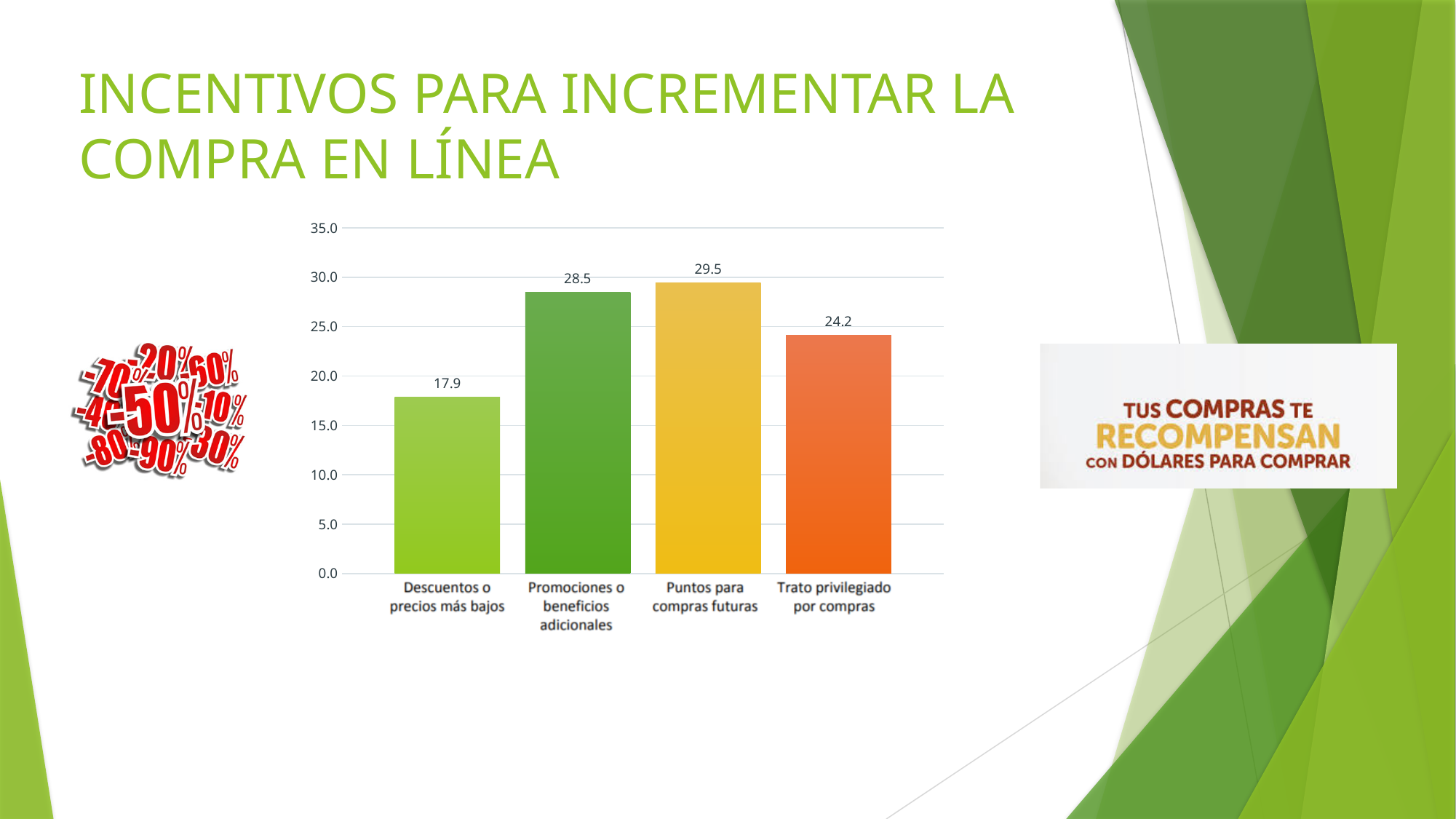
Which category has the lowest value? Descuentos o precios más bajos What is the difference between the values for "Puntos para compras futuras" and "Descuentos o precios más bajos"? 11.6 What is the value for "Trato privilegiado por compras"? 24.2 What is the value for "Descuentos o precios más bajos"? 17.9 What is the value for "Puntos para compras futuras"? 29.5 How many categories are shown in the chart? 4 What is the value for "Promociones o beneficios adicionales"? 28.5 Which is larger, the value for "Trato privilegiado por compras" or the value for "Descuentos o precios más bajos"? Trato privilegiado por compras Which category has the highest value? Puntos para compras futuras Is the value for "Trato privilegiado por compras" greater or less than 25.0? less What is the difference between the values for "Promociones o beneficios adicionales" and "Trato privilegiado por compras"? 4.3 What kind of chart is shown on the slide? Bar chart